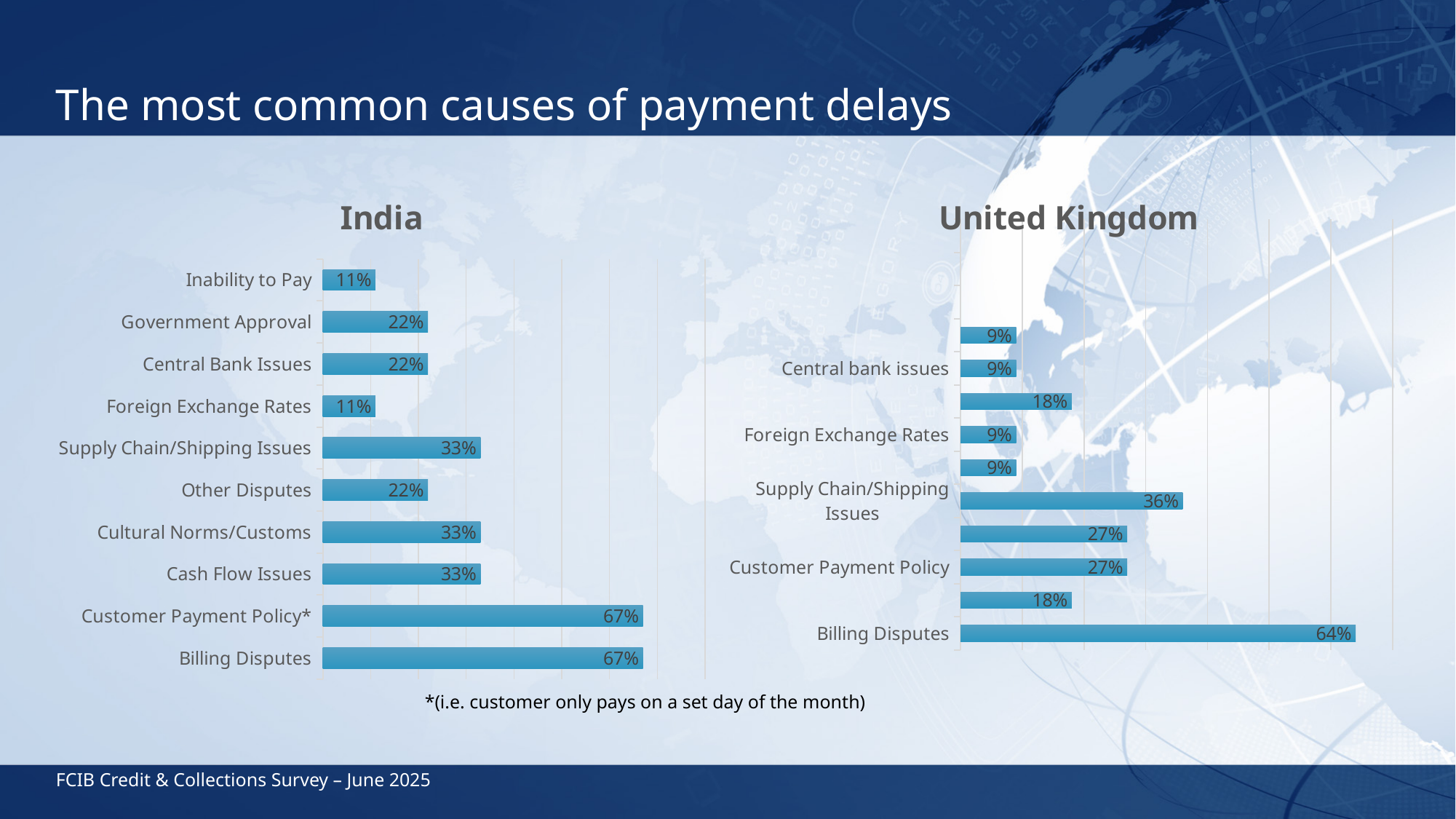
What kind of chart is the India chart? Bar chart In the India chart, what is the value for Government Approval? 22% In the India chart, what is the difference between Billing Disputes and Cash Flow Issues? 34% In the United Kingdom chart, what is the value for Supply Chain/Shipping Issues? 36% In the India chart, what is the value for Supply Chain/Shipping Issues? 33% What is the difference between the Billing Disputes value in the India chart and the Billing Disputes value in the United Kingdom chart? 3% In the United Kingdom chart, what is the value for Billing Disputes? 64% In the India chart, which is larger: Other Disputes or Cultural Norms/Customs? Cultural Norms/Customs In the United Kingdom chart, which labelled category has the highest value? Billing Disputes In the United Kingdom chart, what is the value for Customer Payment Policy? 27% In the India chart, what is the value for Inability to Pay? 11% How many categories are shown in the India chart? 10